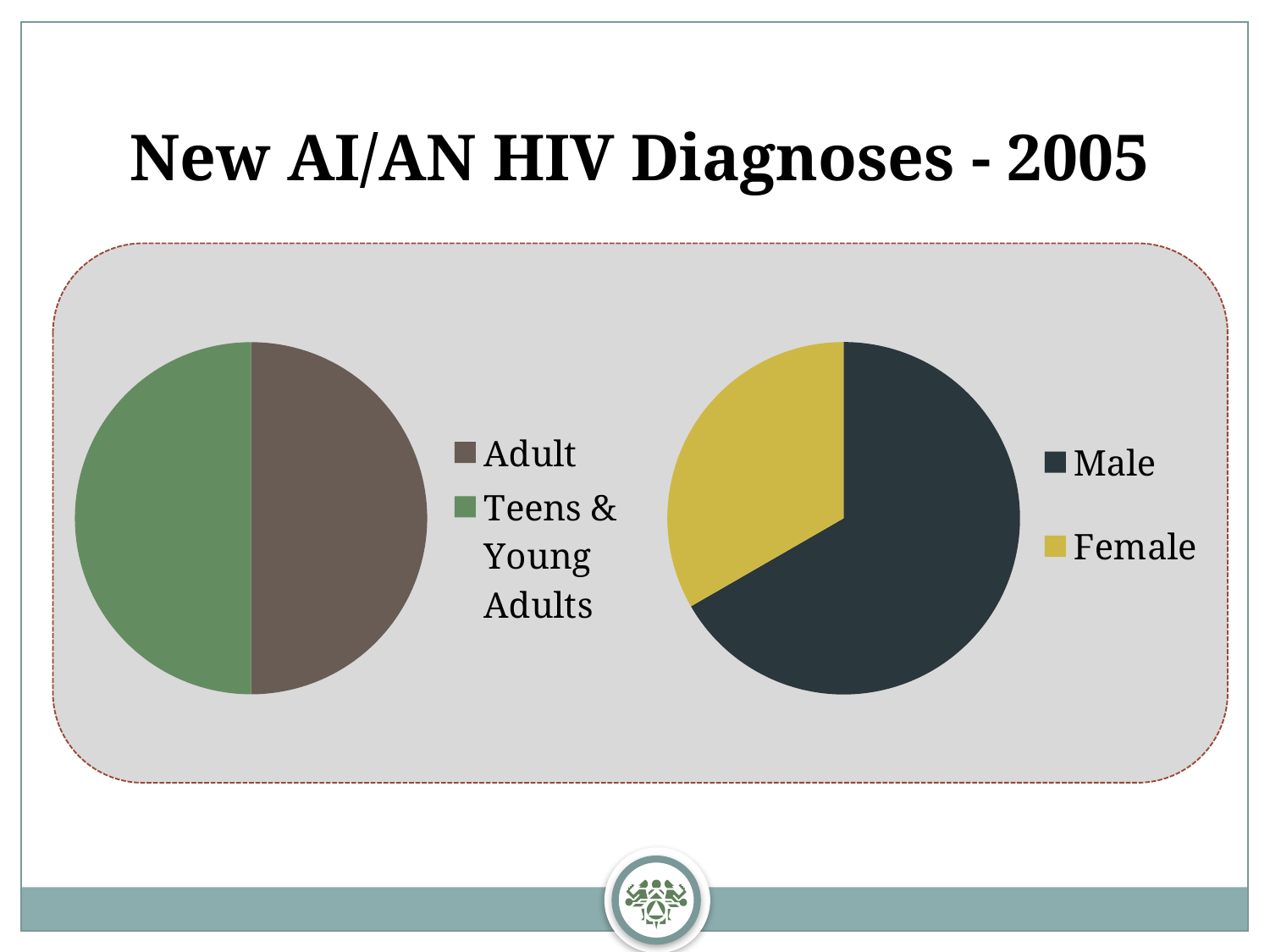
What is the title of the slide containing the two pie charts? New AI/AN HIV Diagnoses - 2005 In the left pie chart, how many categories does the legend list? 2 What kind of chart is the left chart on the slide? pie chart How many charts are shown on the slide? 2 In the right pie chart, how many categories does the legend list? 2 What kind of chart is the right chart on the slide? pie chart In the right pie chart, what colour is the Female slice? yellow In the right pie chart, which slice is larger, Male or Female? Male In the left pie chart, what are the two categories listed in the legend? Adult; Teens & Young Adults In the right pie chart, which category has the largest slice? Male In the right pie chart, which category has the smallest slice? Female